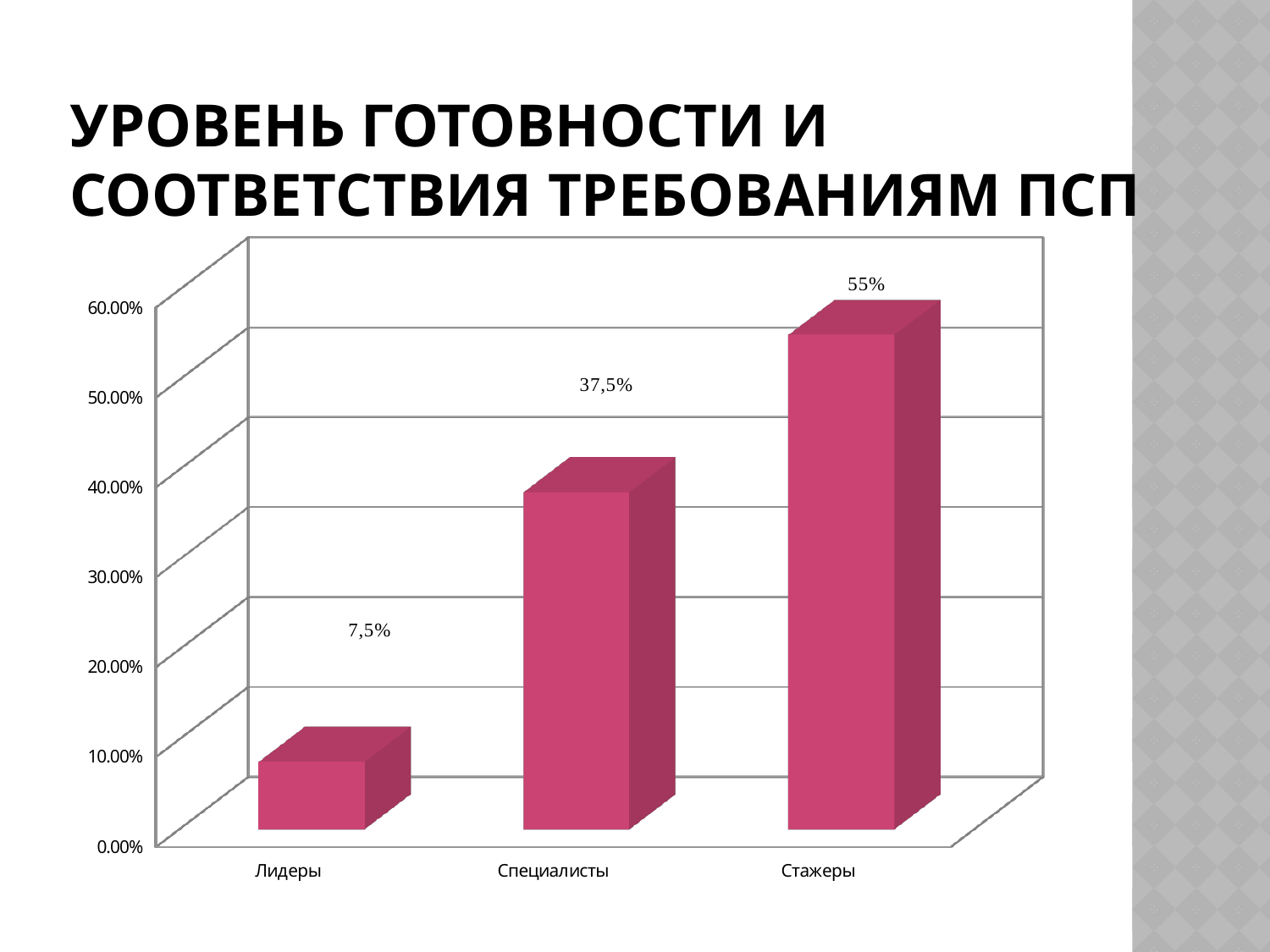
Which category has the highest value? Стажеры What is the difference between the values for Специалисты and Лидеры? 30% What is the value for Специалисты? 37,5% Which category has the lowest value? Лидеры What kind of chart is shown on the slide? bar chart What is the value for Лидеры? 7,5% What is the value for Стажеры? 55% Do the values rise or fall from left to right along the x axis? rise Which is larger, the value for Лидеры or the value for Специалисты? Специалисты How many categories are shown on the x axis? 3 Is the value for Стажеры greater or less than 50.00%? greater What is the difference between the values for Стажеры and Специалисты? 17,5%